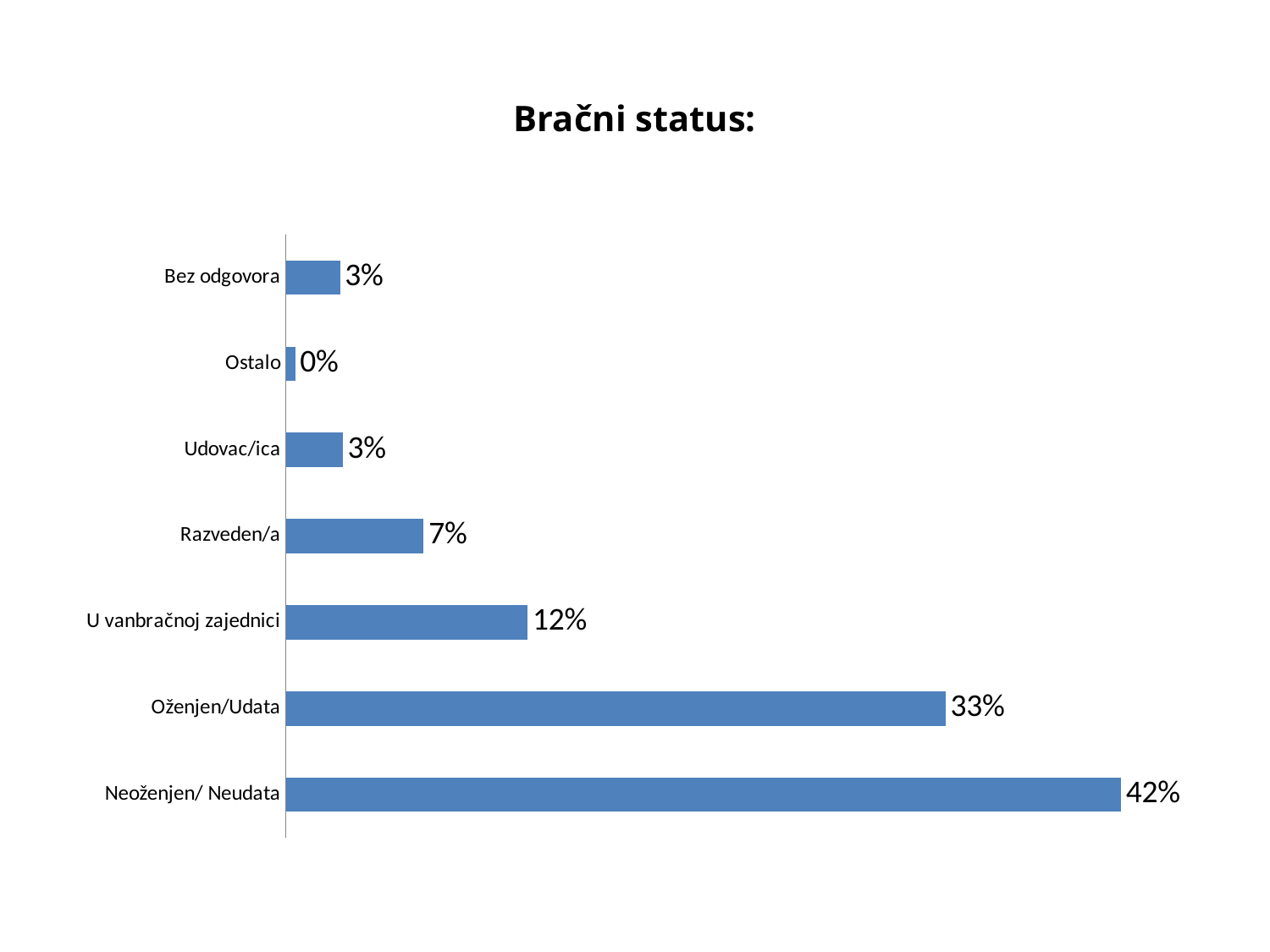
What is the title of the chart? Bračni status: What is the value for Neoženjen/ Neudata? 42% What is the value for Razveden/a? 7% What is the value for Oženjen/Udata? 33% Which category has the highest value? Neoženjen/ Neudata Which category has the lowest value? Ostalo What is the value for U vanbračnoj zajednici? 12% Which is larger, the value for U vanbračnoj zajednici or the value for Razveden/a? U vanbračnoj zajednici How many categories are shown in the chart? 7 What kind of chart is shown on the slide? Bar chart What is the difference between the values for Neoženjen/ Neudata and Oženjen/Udata? 9% What is the value for Ostalo? 0%